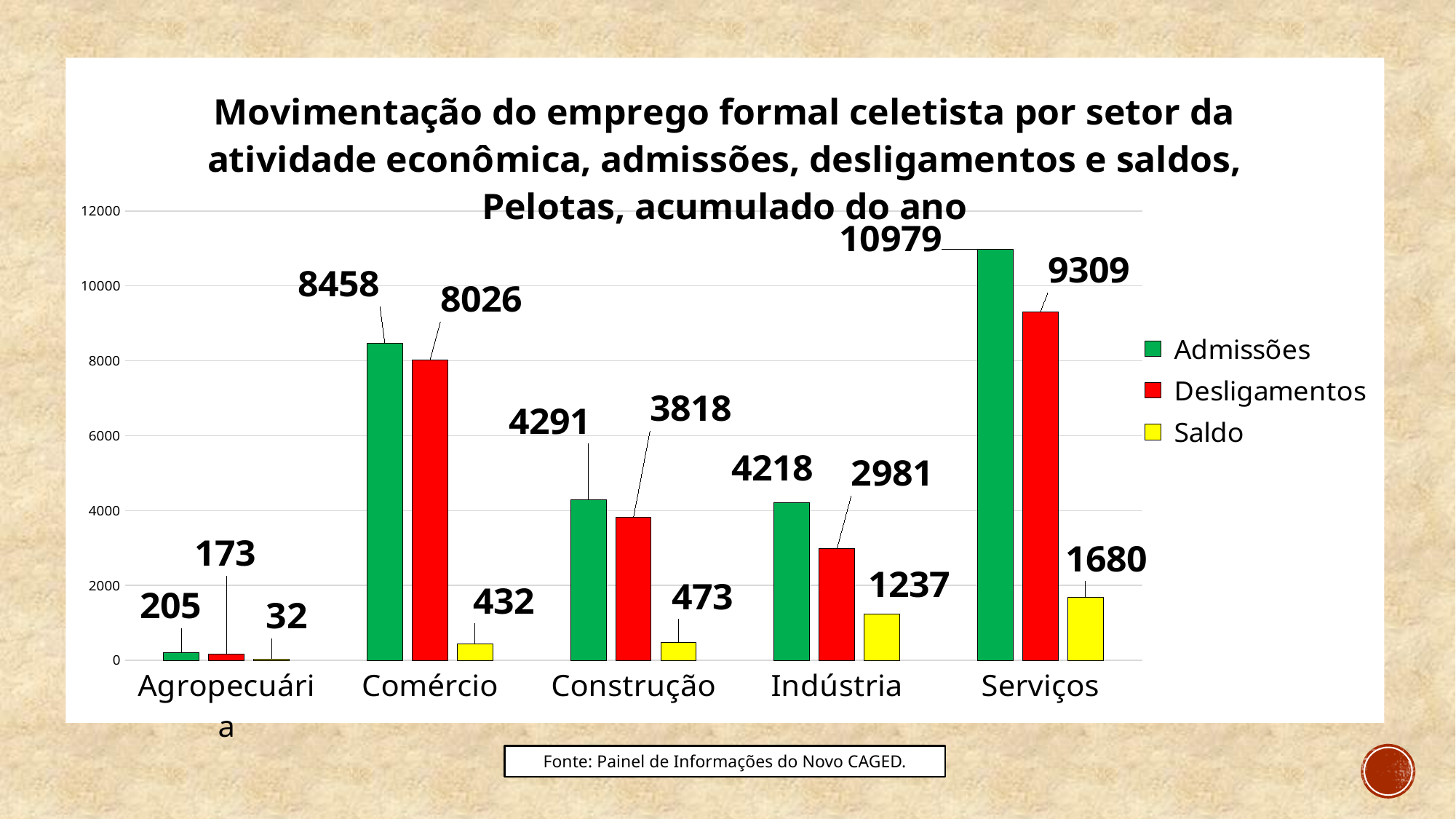
How many sectors are shown on the x axis? 5 What is the Desligamentos value for Indústria? 2981 What is the Saldo value for Serviços? 1680 What is the difference between Admissões and Desligamentos for Serviços? 1670 What is the Admissões value for Comércio? 8458 Is the Desligamentos value for Comércio greater or less than 6000? greater Which sector has the lowest Saldo value? Agropecuária Which sector has the highest Admissões value? Serviços How many series does the legend list? 3 What kind of chart is shown on the slide? Bar chart Which is larger for Construção: Admissões or Desligamentos? Admissões What colour represents the Saldo series? Yellow